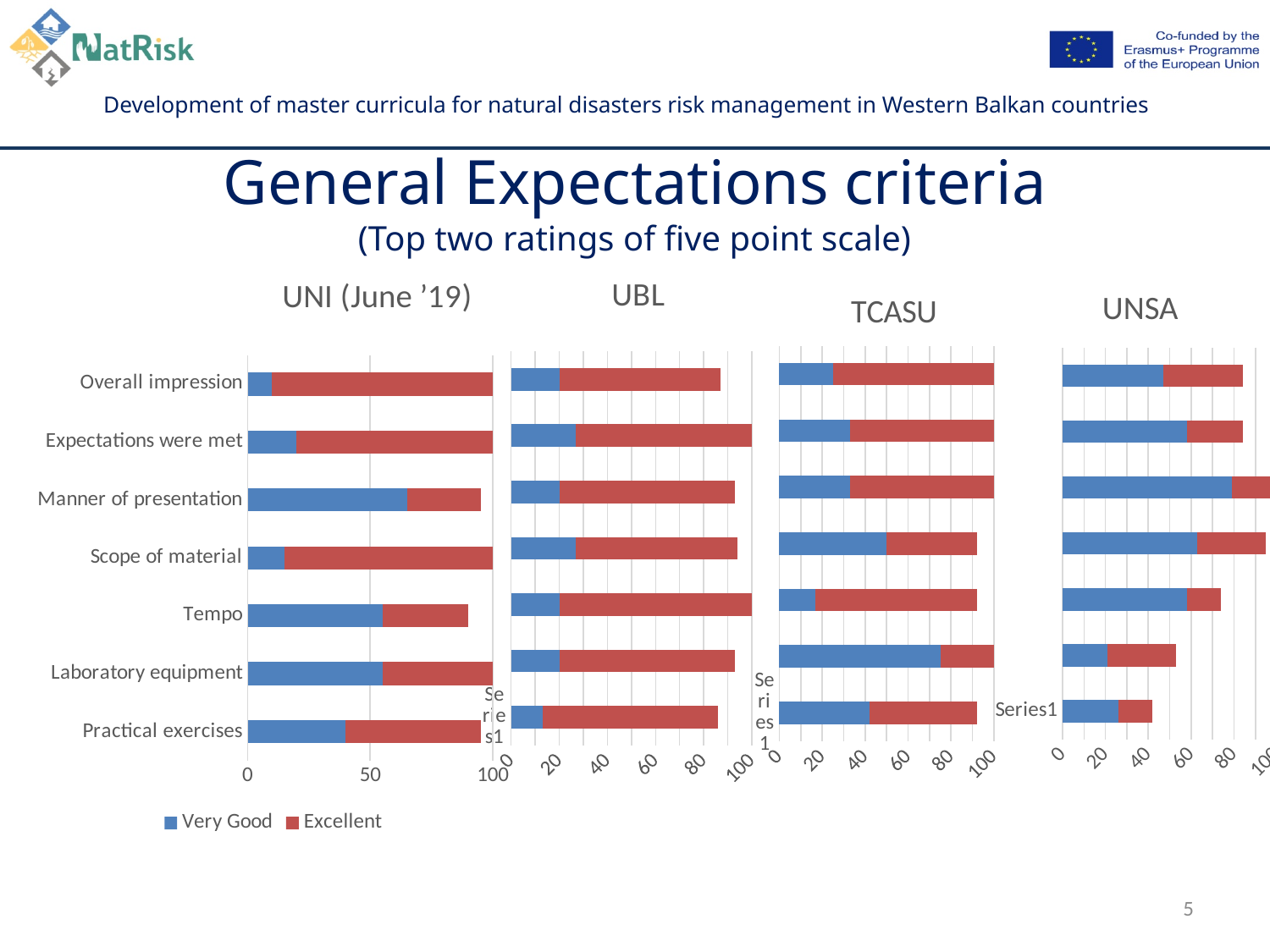
In the UBL chart, is the Very Good value for Practical exercises greater or less than 20? less In the UNI (June '19) chart, is the Very Good value for Overall impression greater or less than 50? less In the UNSA chart, which category has the highest Very Good value? Manner of presentation In the UNSA chart, is the Very Good value for Practical exercises greater or less than 40? less How many series does the legend list for the UNI (June '19) chart? 2 What kind of chart is the UNI (June '19) chart? bar chart How many categories are listed on the UNI (June '19) chart? 7 In the TCASU chart, which category has the lowest Very Good value? Tempo In the UNSA chart, which category has the shortest total stacked bar? Practical exercises What are the two series named in the legend of the UNI (June '19) chart? Very Good and Excellent